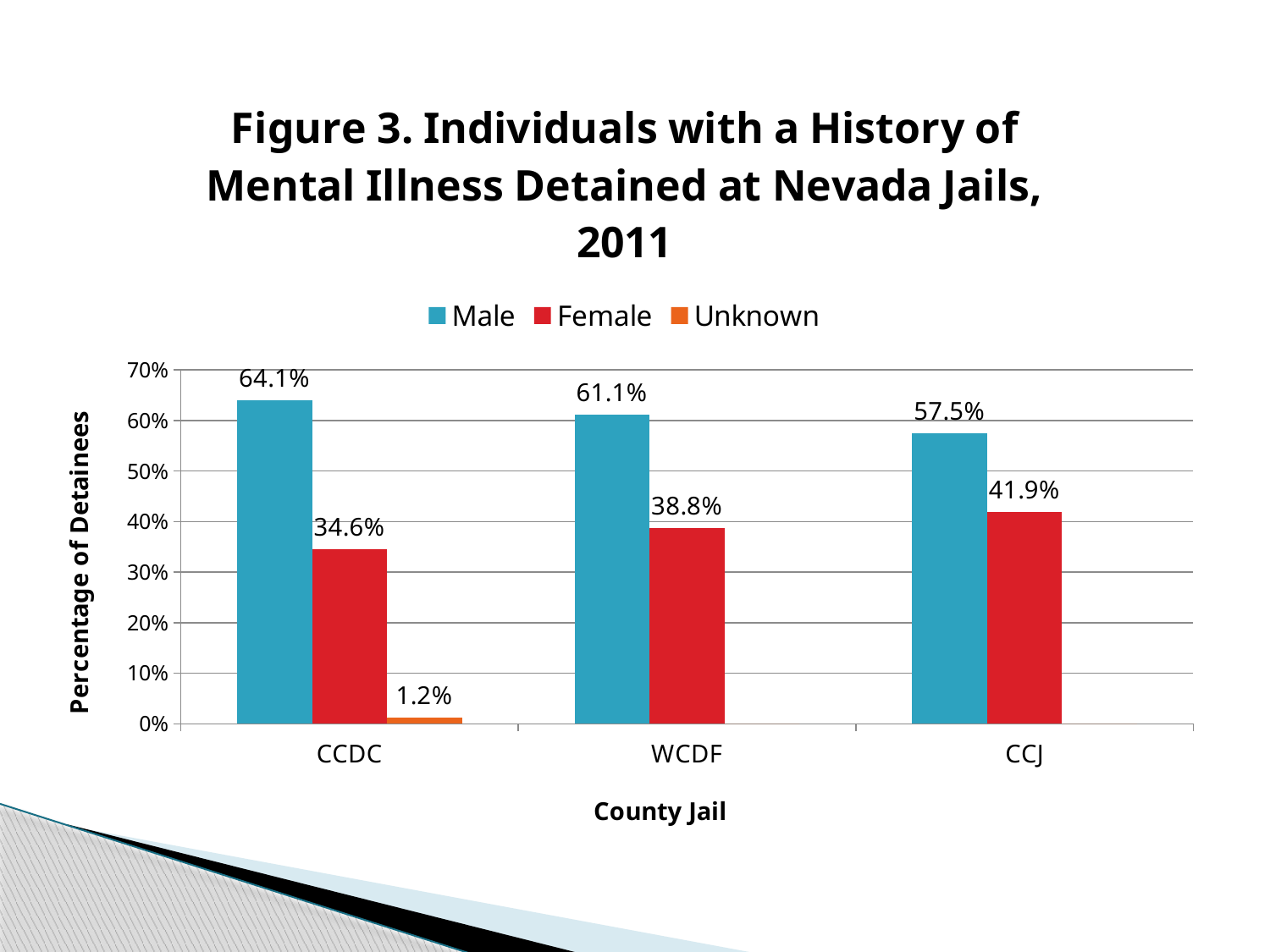
Which is larger, the Female value for CCJ or the Female value for WCDF? CCJ What is the label of the y axis? Percentage of Detainees What kind of chart is shown on the slide? bar chart How many series does the legend list? 3 Which county jail has the lowest Female value? CCDC Is the Male value for WCDF greater or less than 60%? greater What is the Unknown value for CCDC? 1.2% Which county jail has the highest Male value? CCDC What is the Male value for CCDC? 64.1% What is the difference between the Male and Female values for CCJ? 15.6% How many county jails are shown on the x axis? 3 What is the Female value for WCDF? 38.8%